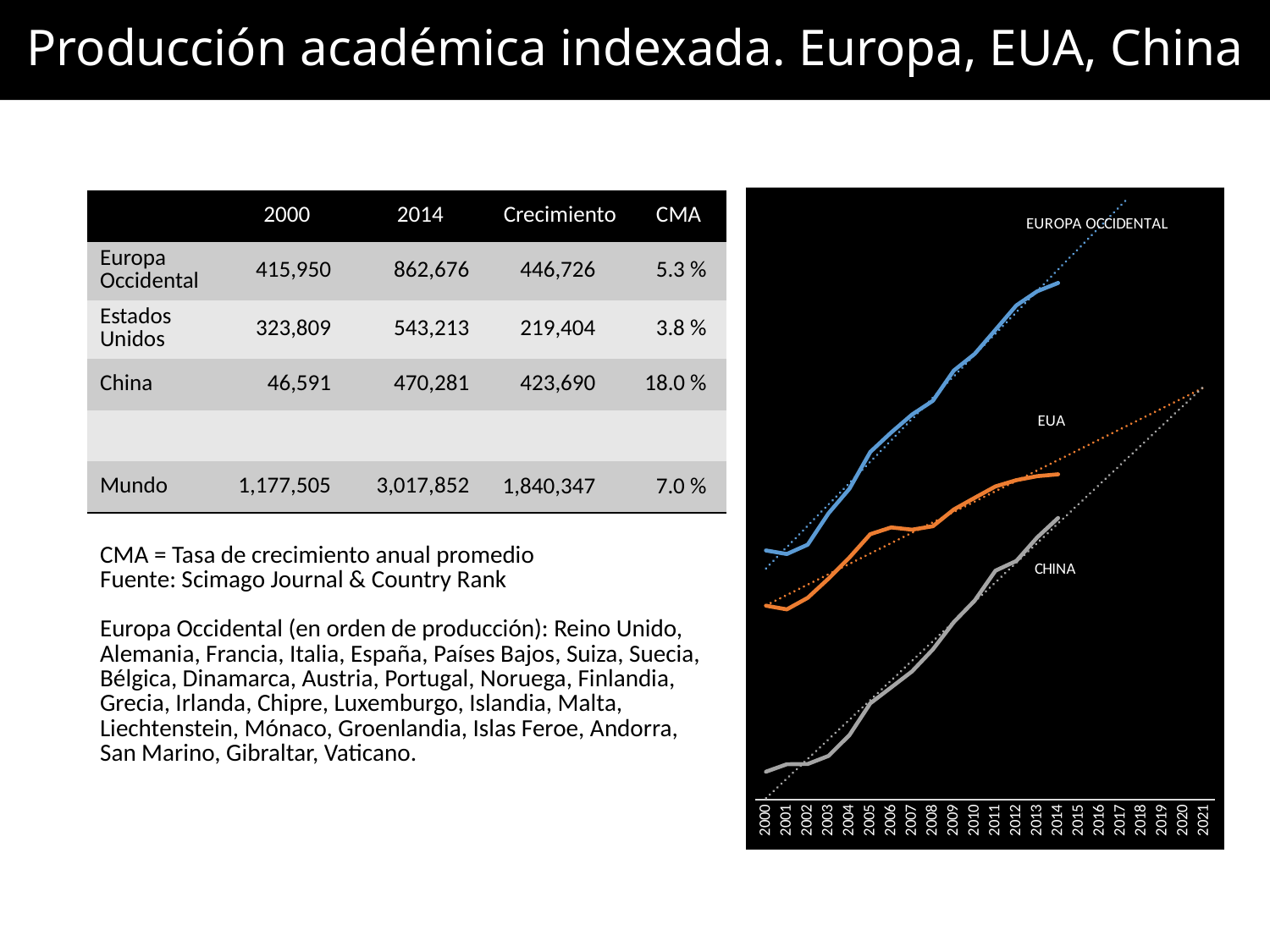
Which series has the lowest line in the chart? CHINA Which is higher in the chart, the EUA line or the CHINA line? EUA Does the EUROPA OCCIDENTAL line rise or fall across the years shown? rise Which series has the highest line in the chart? EUROPA OCCIDENTAL Does the CHINA line rise or fall from 2000 to 2014? rise What kind of chart is shown on the right side of the slide? line chart How many year labels are on the x axis of the chart? 22 What is the first year shown on the x axis of the chart? 2000 How many series are plotted as solid lines in the chart? 3 What is the last year shown on the x axis of the chart? 2021 According to the table on the slide, what was the value for China in 2014? 470,281 According to the table on the slide, what was the value for Europa Occidental in 2000? 415,950